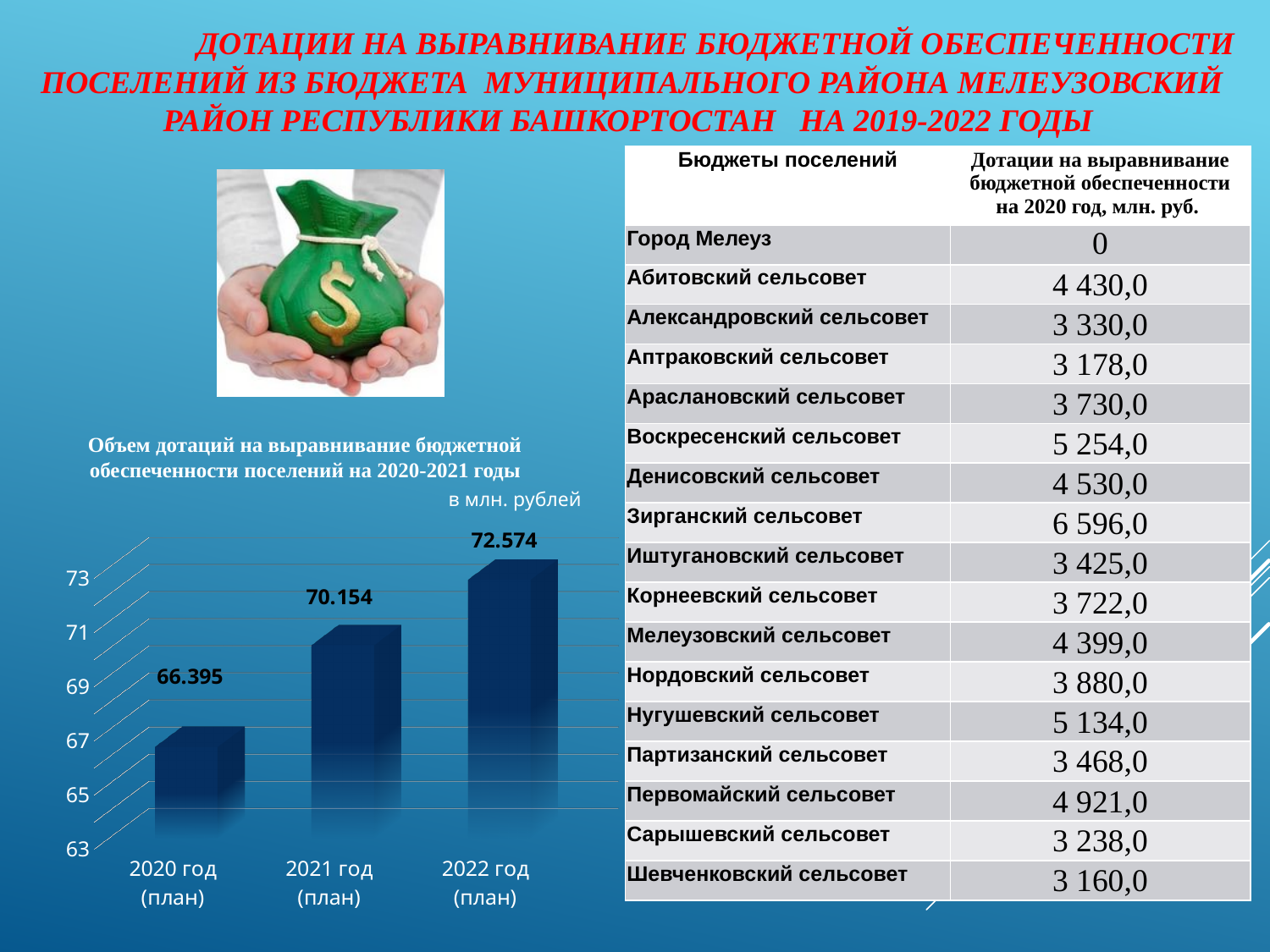
How many bars are shown in the chart? 3 Which year has the lowest value in the chart? 2020 год (план) What is the value for 2020 год (план) in the chart? 66.395 Which year has the highest value in the chart? 2022 год (план) What is the difference between the values for 2022 год (план) and 2021 год (план)? 2.420 What kind of chart is shown on the slide? bar chart What is the value for 2021 год (план) in the chart? 70.154 What is the difference between the values for 2021 год (план) and 2020 год (план)? 3.759 Do the values rise or fall from 2020 to 2022 along the x axis? rise What is the value for 2022 год (план) in the chart? 72.574 Is the value for 2020 год (план) greater or less than 67? less Which is larger, the value for 2021 год (план) or the value for 2022 год (план)? 2022 год (план)